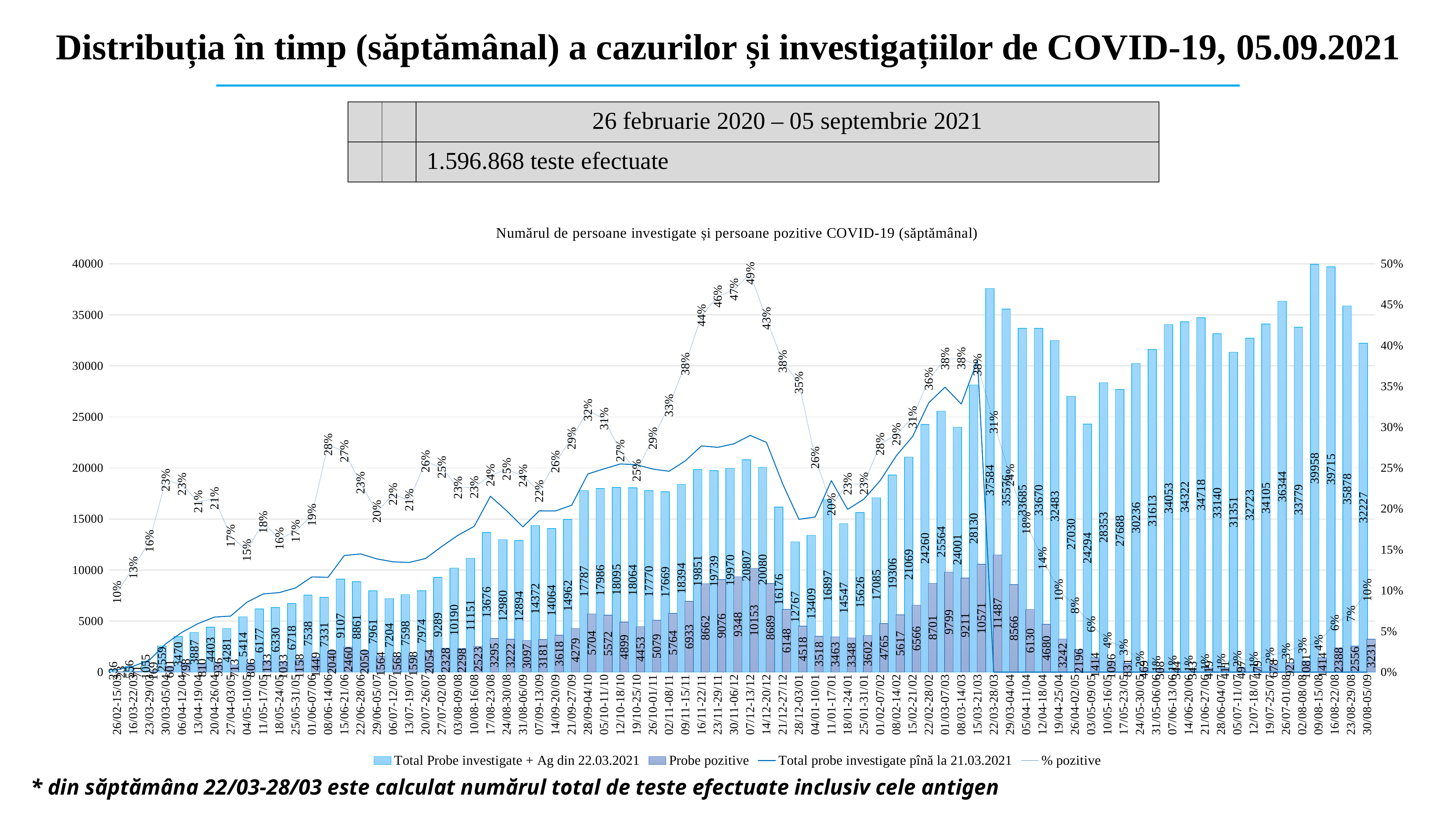
What is the title of the chart? Numărul de persoane investigate și persoane pozitive COVID-19 (săptămânal) Which week has the highest 'Total Probe investigate + Ag din 22.03.2021' bar? 09/08-15/08 What is the difference between the total probe values for the weeks 09/08-15/08 and 16/08-22/08? 243 Is the total probe value for the week 26/07-01/08 greater or less than 30000? greater What is the highest '% pozitive' value shown on the chart? 49% What is the value of 'Probe pozitive' for the week 30/08-05/09? 3231 Which week has the larger 'Probe pozitive' value: 15/03-21/03 or 22/03-28/03? 22/03-28/03 What is the value of 'Total Probe investigate + Ag din 22.03.2021' for the week 30/08-05/09? 32227 What is the 'Probe pozitive' value for the week 07/12-13/12? 10153 What is the '% pozitive' value for the week 07/12-13/12? 49% What kind of chart is shown on the slide? A combination bar and line chart How many series does the legend list? 4